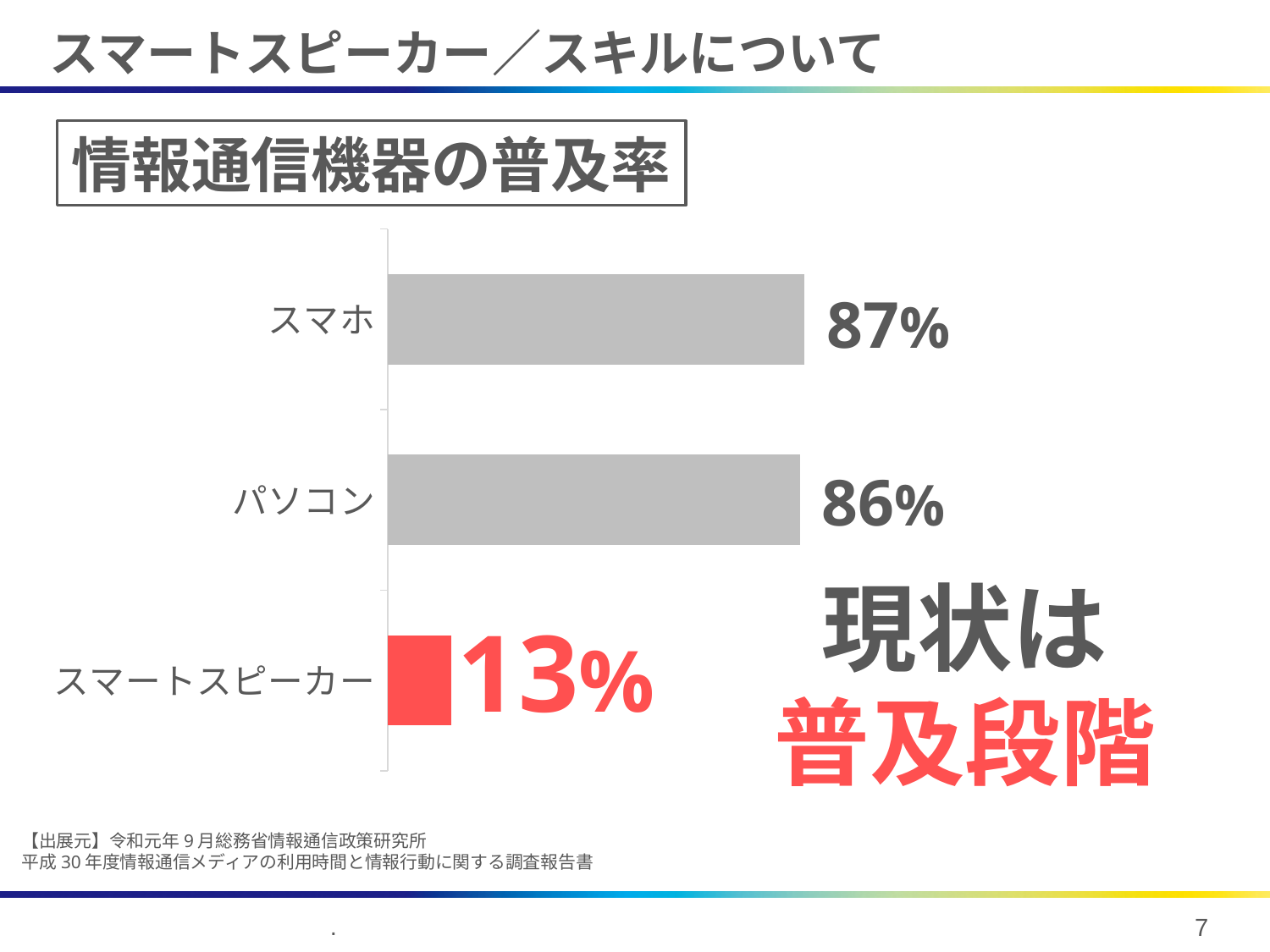
Which bar is coloured red? スマートスピーカー What is the value for スマートスピーカー? 13% What is the value for スマホ? 87% What is the value for パソコン? 86% What kind of chart is shown on the slide? bar chart Which category has the lowest value? スマートスピーカー What is the difference between the values for スマホ and スマートスピーカー? 74% Which category has the highest value? スマホ Which is larger, the value for パソコン or the value for スマートスピーカー? パソコン What is the title of the chart? 情報通信機器の普及率 How many categories are shown in the chart? 3 What is the difference between the values for パソコン and スマートスピーカー? 73%